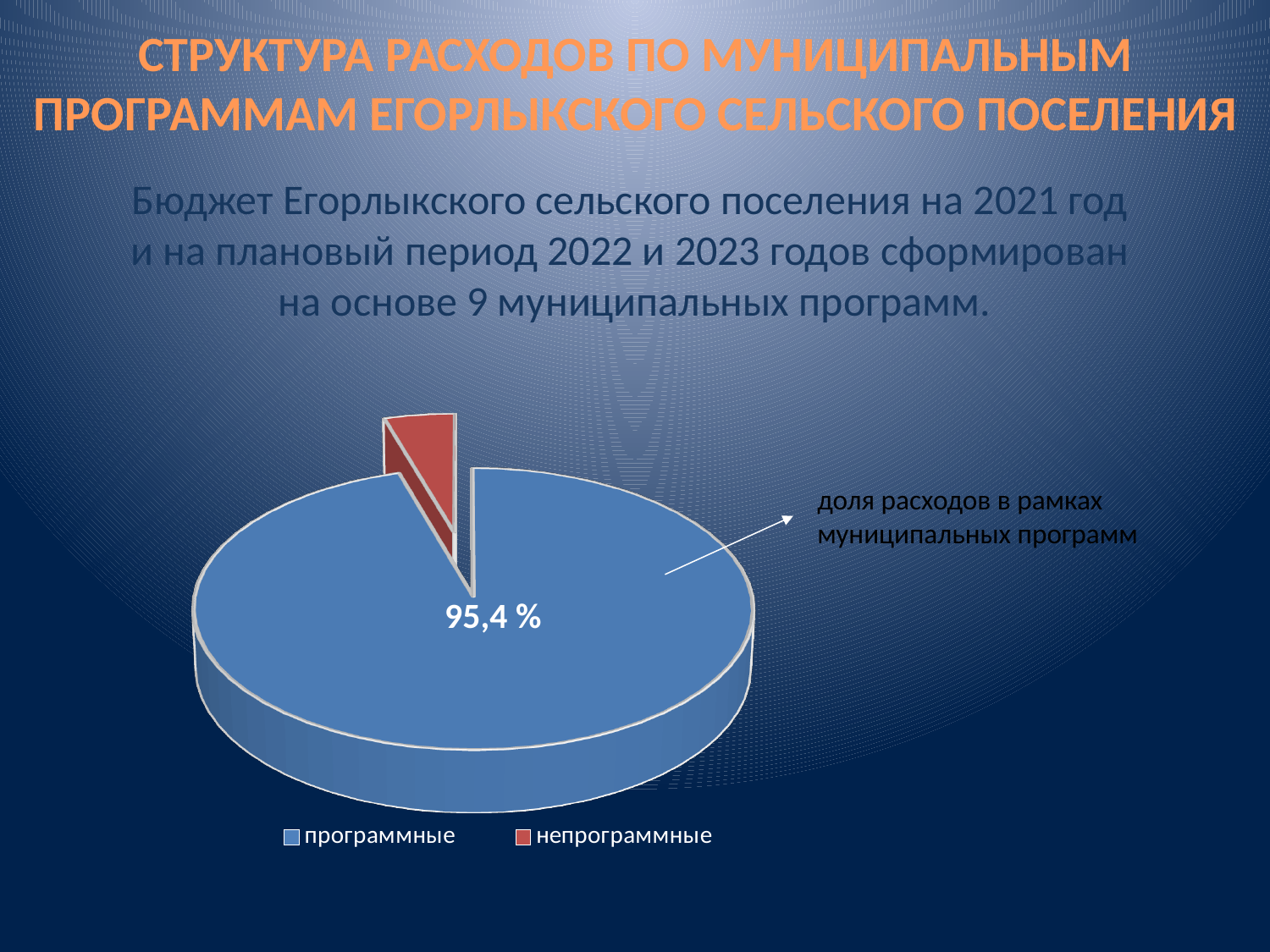
What value is printed on the pie chart for the "программные" slice? 95,4 % What share of the pie does the "программные" slice represent? 95,4 % Which slice of the pie chart is the largest? программные How many slices does the pie chart have? 2 Which is larger in the pie chart: "программные" or "непрограммные"? программные What kind of chart is shown on the slide? pie chart Which slice of the pie chart is the smallest? непрограммные What colour is the "непрограммные" slice in the pie chart? red How many entries does the legend of the pie chart list? 2 What does the annotation with the arrow pointing to the blue slice say? доля расходов в рамках муниципальных программ